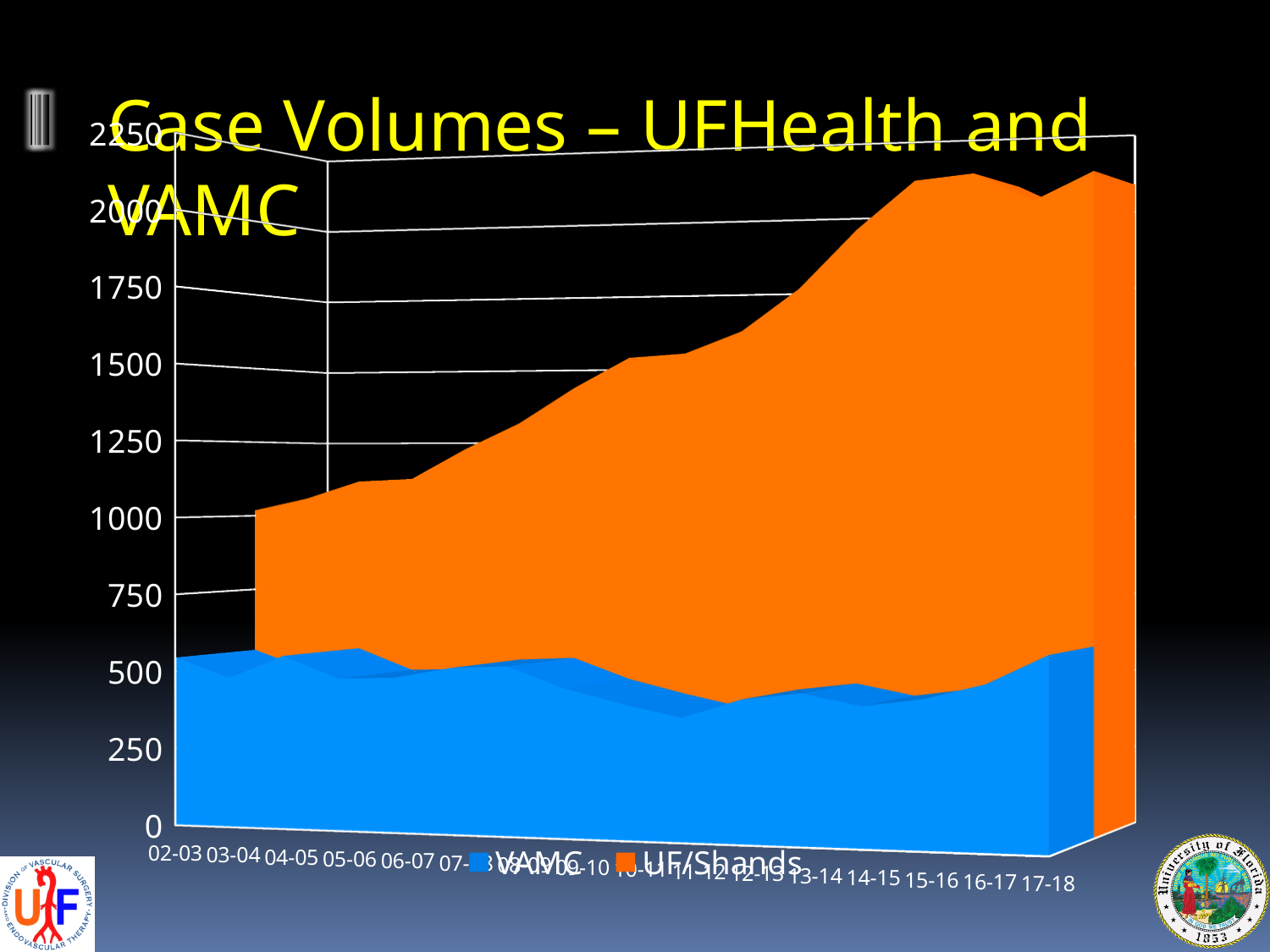
How many series does the chart legend list? 2 Which two series are listed in the chart legend? VAMC and UF/Shands Does the total stacked case volume generally rise or fall from 02-03 to 17-18? rise Which series is larger in 17-18, VAMC or UF/Shands? UF/Shands What kind of chart is shown on the slide? area chart Is the VAMC value for 02-03 greater or less than 250? greater Is the total stacked value for 15-16 greater or less than 1500? greater Is the VAMC value for 02-03 greater or less than 1000? less How many academic-year categories are shown on the x axis? 16 What is the first category on the x axis? 02-03